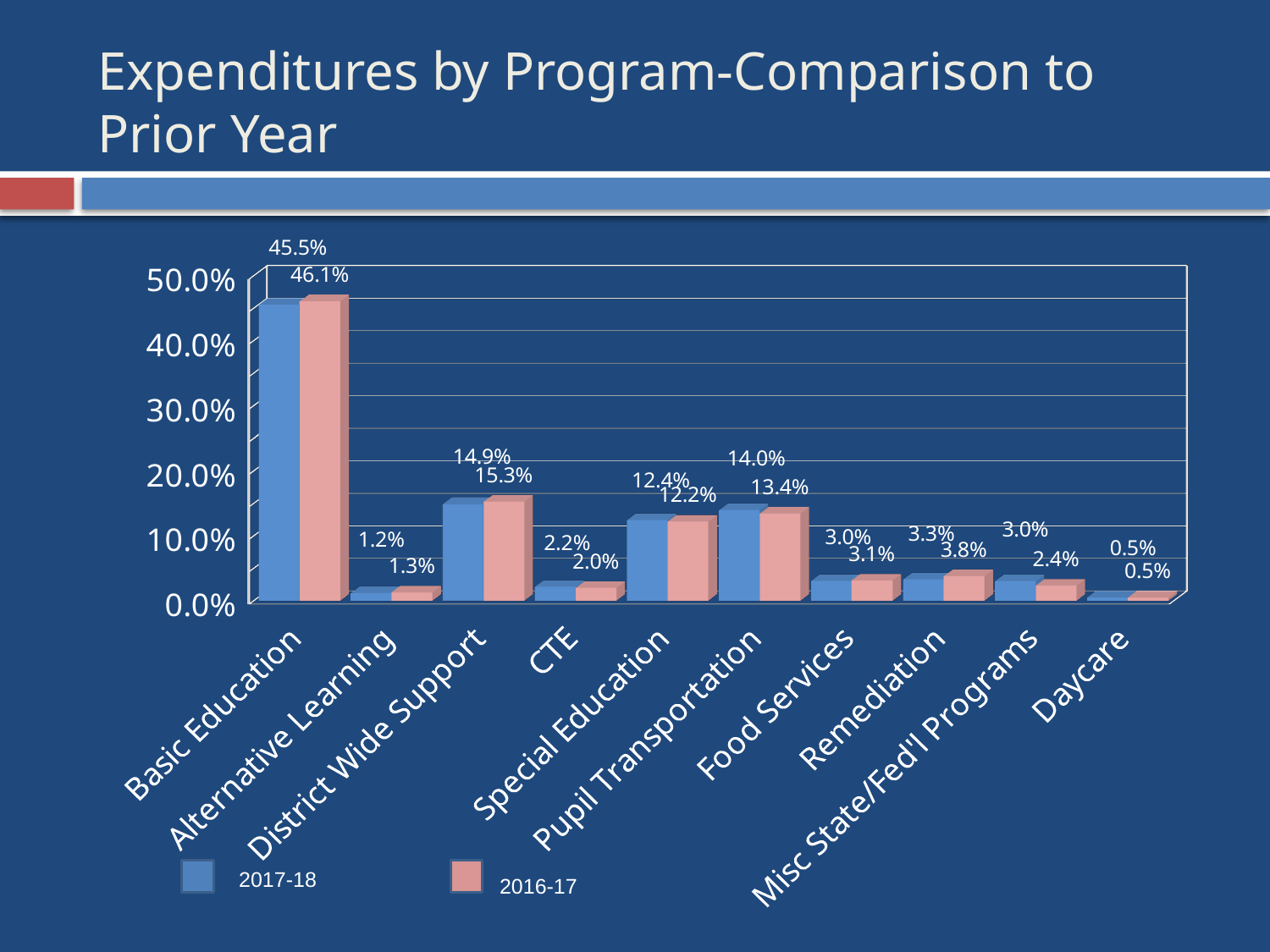
How many categories are shown on the x axis? 10 Which category has the highest 2017-18 value? Basic Education What is the 2017-18 value for Pupil Transportation? 14.0% What is the 2016-17 value for District Wide Support? 15.3% What is the difference between the 2016-17 and 2017-18 values for Basic Education? 0.6% What is the 2017-18 value for Basic Education? 45.5% Which category has the lowest 2016-17 value? Daycare How many series does the legend list? 2 What is the 2016-17 value for Remediation? 3.8% Is the 2017-18 value for Special Education greater or less than 10.0%? greater For Misc State/Fed'l Programs, which series has the larger value, 2017-18 or 2016-17? 2017-18 What kind of chart is shown on the slide? Bar chart